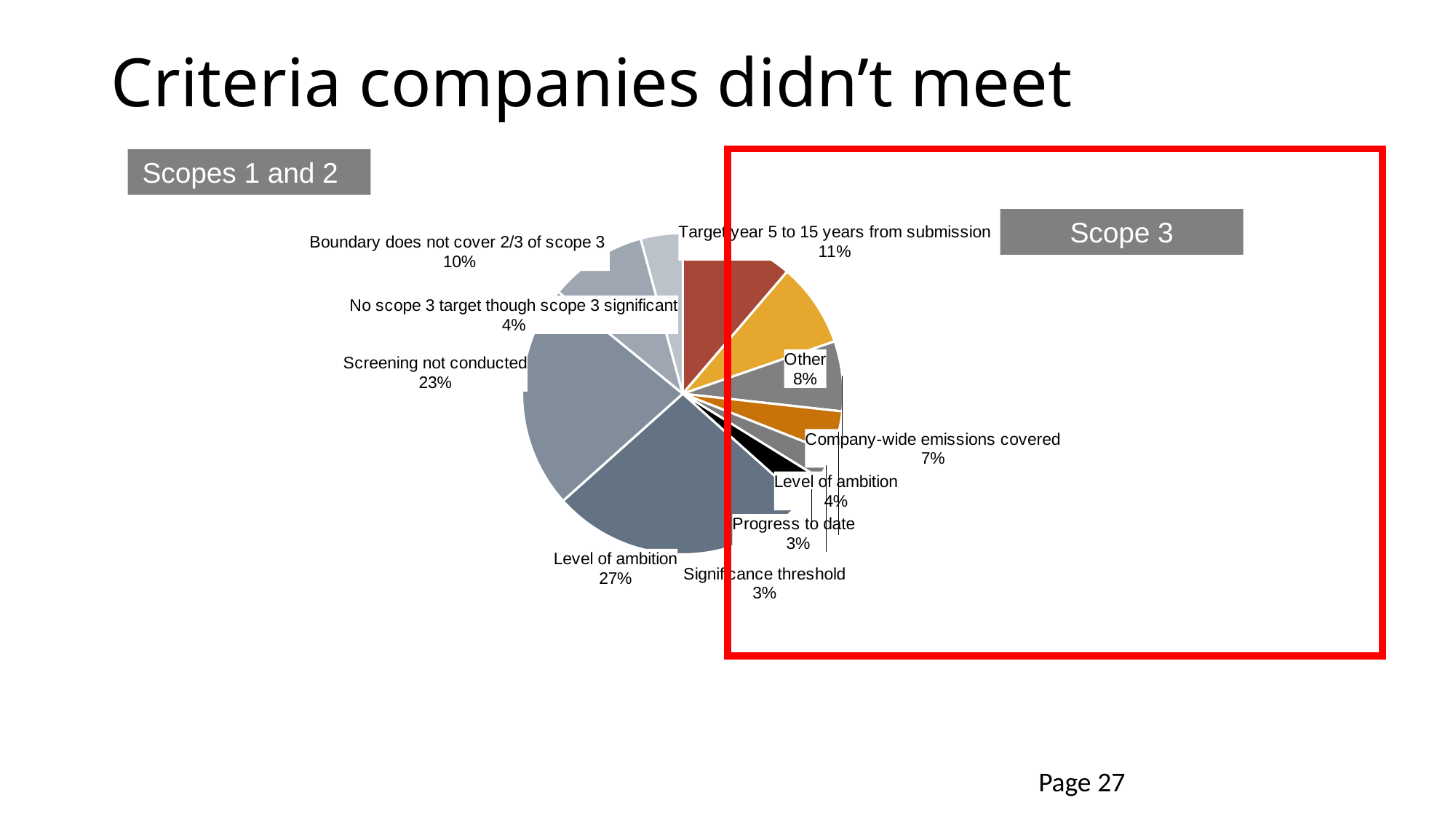
What percentage is shown for the 'Other' slice? 8% What percentage is shown for 'Boundary does not cover 2/3 of scope 3'? 10% How many slices does the pie chart have? 10 What kind of chart is shown on the slide? Pie chart What is the difference in percentage points between 'Screening not conducted' and 'Boundary does not cover 2/3 of scope 3'? 13 percentage points What percentage is shown for 'No scope 3 target though scope 3 significant'? 4% Which slice of the pie chart has the largest share? Level of ambition (27%) Which is larger, the 'Other' slice or the 'Company-wide emissions covered' slice? Other What is the title of the slide containing the pie chart? Criteria companies didn't meet What percentage is shown for the 'Screening not conducted' slice? 23% What percentage is shown for 'Company-wide emissions covered'? 7% What percentage is shown for 'Target year 5 to 15 years from submission'? 11%